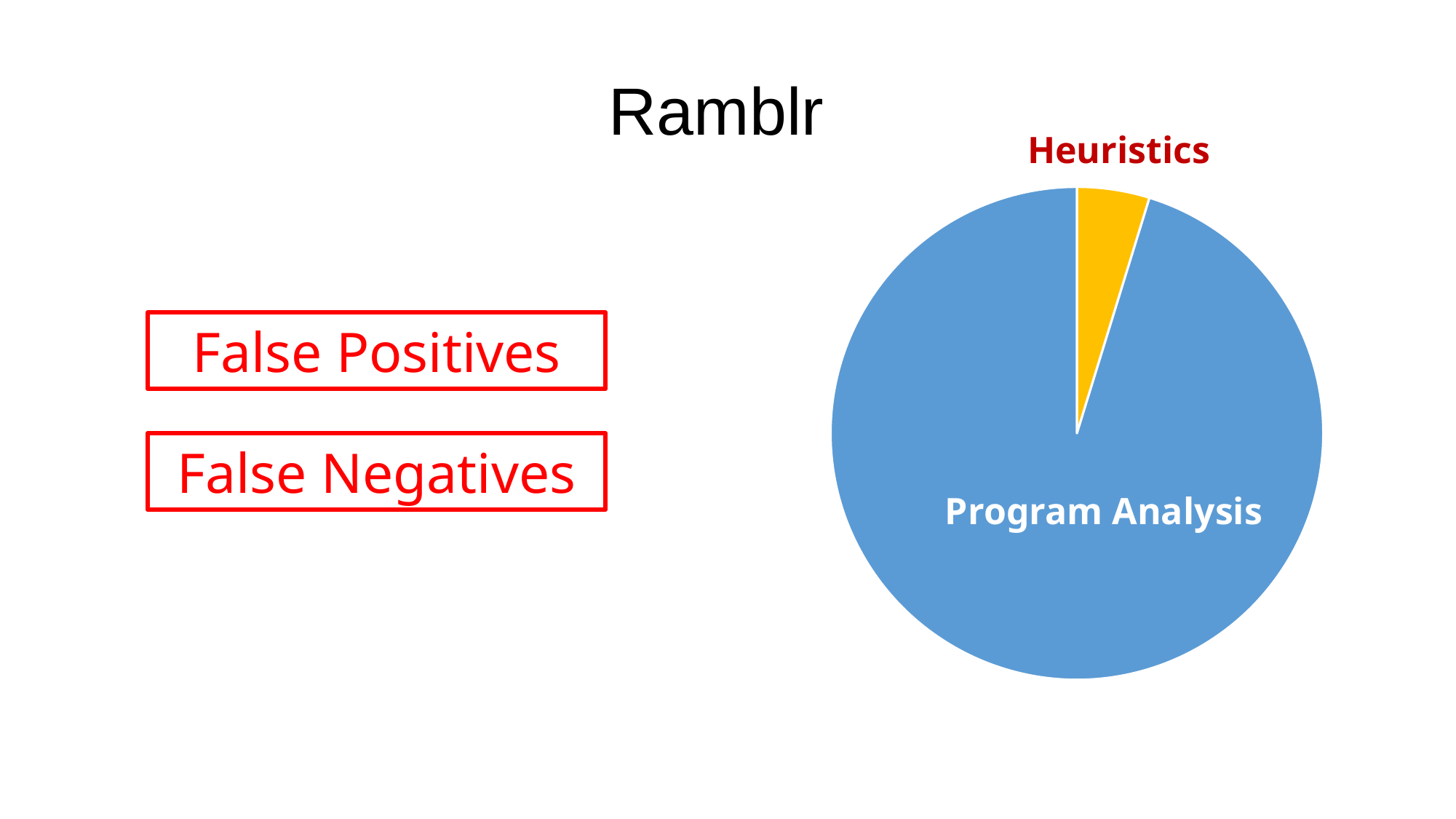
Which slice of the pie chart is the smallest? Heuristics What colour is the Heuristics slice of the pie chart? yellow What kind of chart is shown on the slide? pie chart Which slice is larger, Program Analysis or Heuristics? Program Analysis What colour is the Program Analysis slice of the pie chart? blue Which slice of the pie chart is the largest? Program Analysis How many slices does the pie chart have? 2